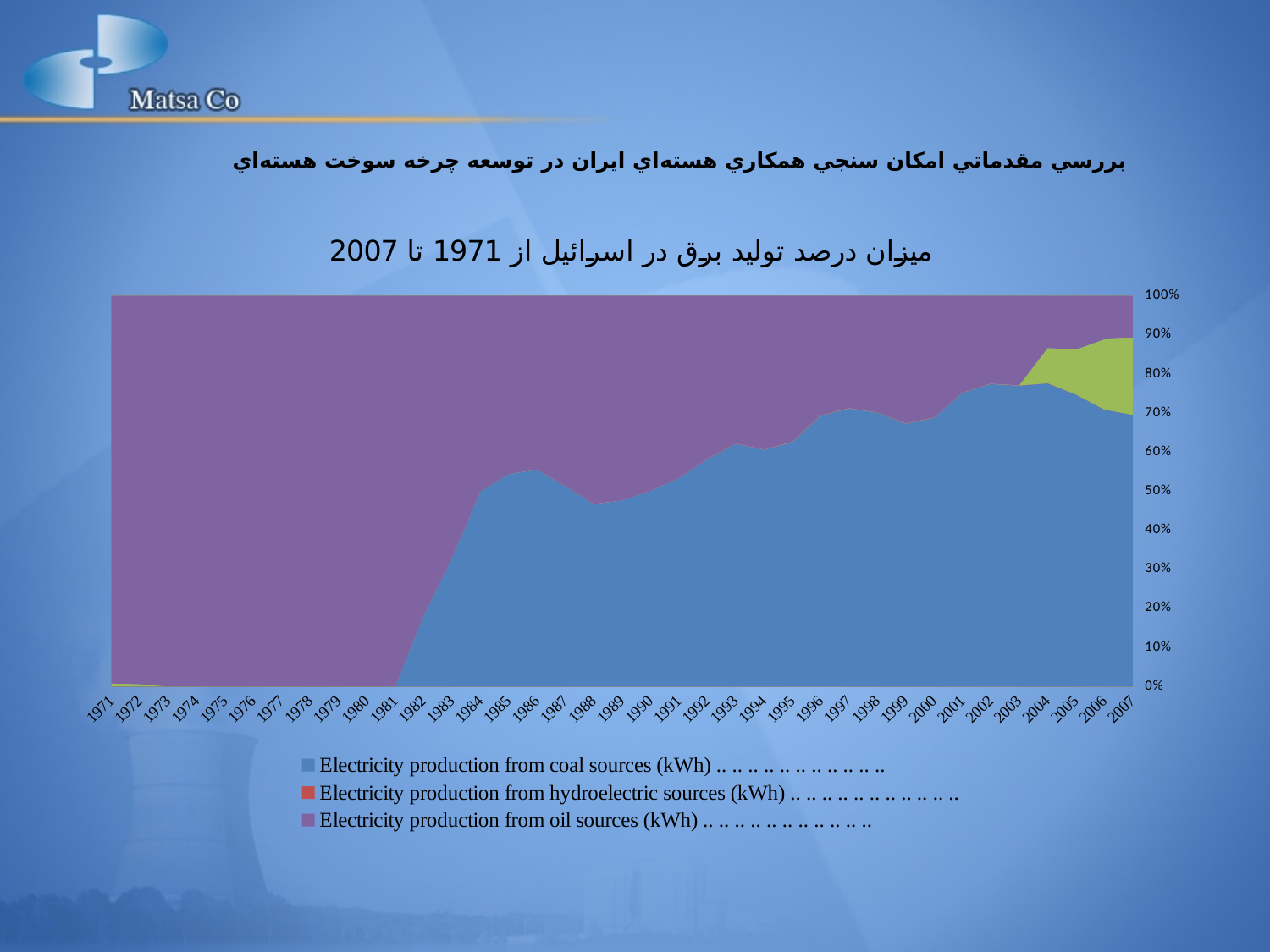
What is the last year shown on the x axis? 2007 Is the share of electricity production from oil sources in 1975 greater or less than 90%? greater Is the share of electricity production from coal sources in 1985 greater or less than 50%? greater In 2007, which is larger: the share of electricity production from coal sources or from oil sources? Coal sources Is the share of electricity production from coal sources in 1975 greater or less than 10%? less In 1975, which is larger: the share of electricity production from coal sources or from oil sources? Oil sources What kind of chart is shown on the slide? Stacked area chart What is the first year shown on the x axis? 1971 How many series does the legend list? 3 Does the share of electricity production from coal sources rise or fall from 1971 to 2007? Rise How many years are shown along the x axis of the chart? 37